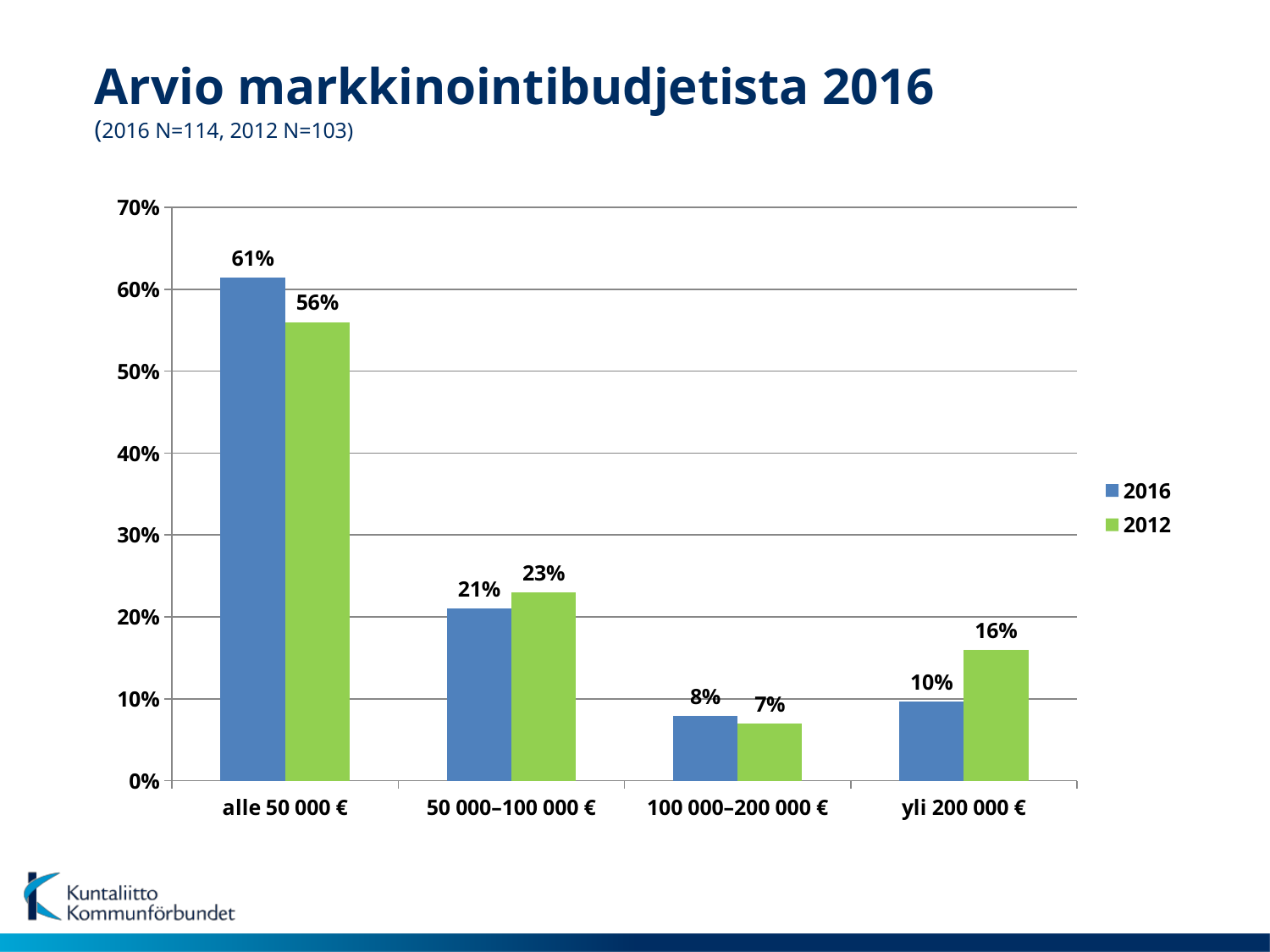
Which category has the lowest value for the 2016 series? 100 000–200 000 € In the '50 000–100 000 €' category, which series has the larger value, 2016 or 2012? 2012 How many categories are shown on the x axis? 4 What is the difference between the 2016 and 2012 values in the 'alle 50 000 €' category? 5% What is the value for 2016 in the 'alle 50 000 €' category? 61% Which category has the highest value for the 2012 series? alle 50 000 € What kind of chart is shown on the slide? bar chart Is the 2016 value for 'alle 50 000 €' greater or less than 50%? greater How many series does the legend list? 2 What is the difference between the 2012 and 2016 values in the 'yli 200 000 €' category? 6% What is the value for 2016 in the '100 000–200 000 €' category? 8% What is the value for 2012 in the 'yli 200 000 €' category? 16%